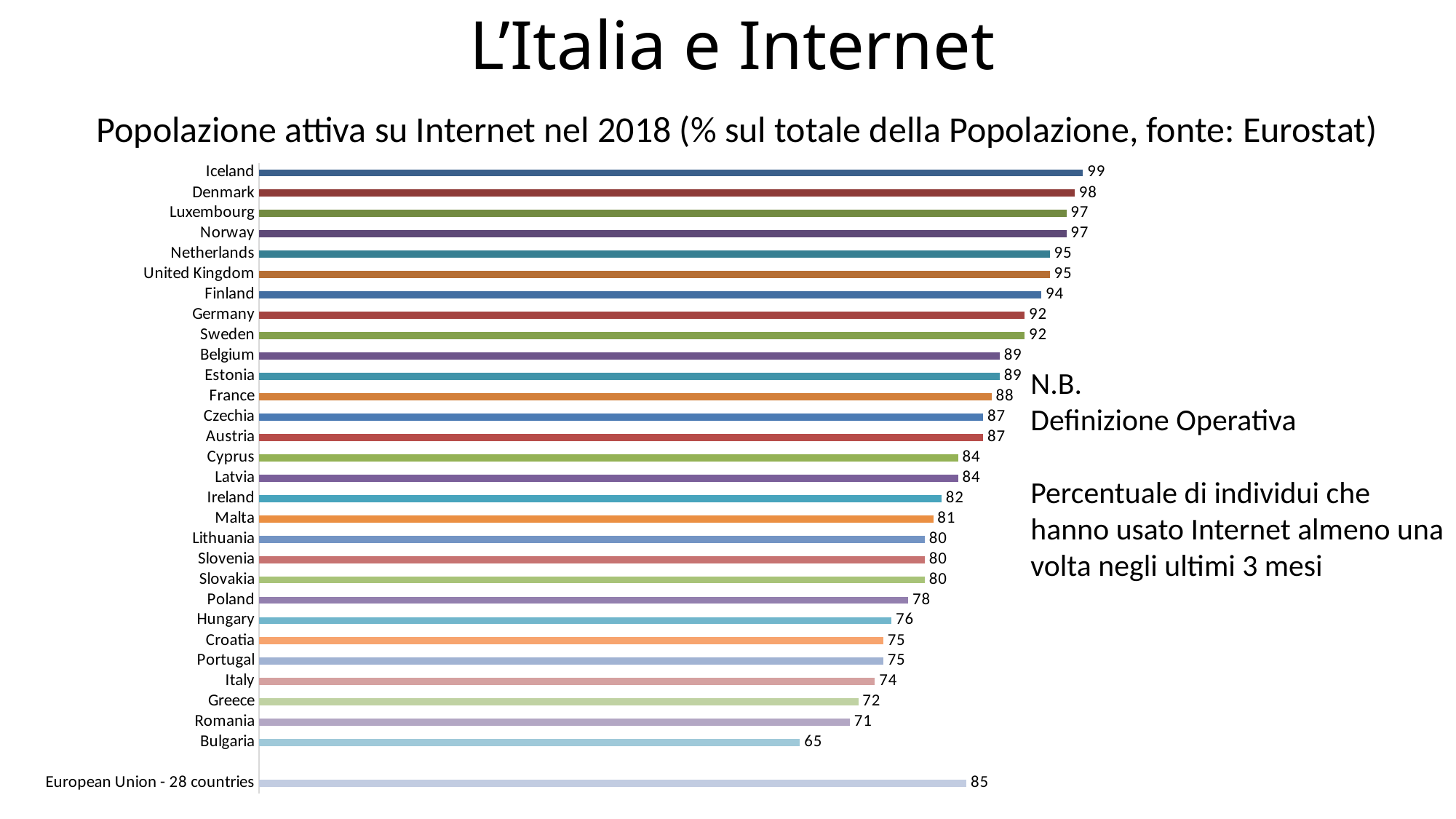
What is the difference between the value for European Union - 28 countries and the value for Italy? 11 What is the value for Germany? 92 What is the difference between the value for Iceland and the value for Bulgaria? 34 Which is larger, the value for Poland or the value for Malta? Malta Which country has the lowest value? Bulgaria What is the value for European Union - 28 countries? 85 What kind of chart is shown on the slide? Bar chart What is the value for Italy? 74 What is the title of the chart? Popolazione attiva su Internet nel 2018 (% sul totale della Popolazione, fonte: Eurostat) Which country has the highest value? Iceland Which is larger, the value for Italy or the value for Greece? Italy How many bars are shown in the chart? 30